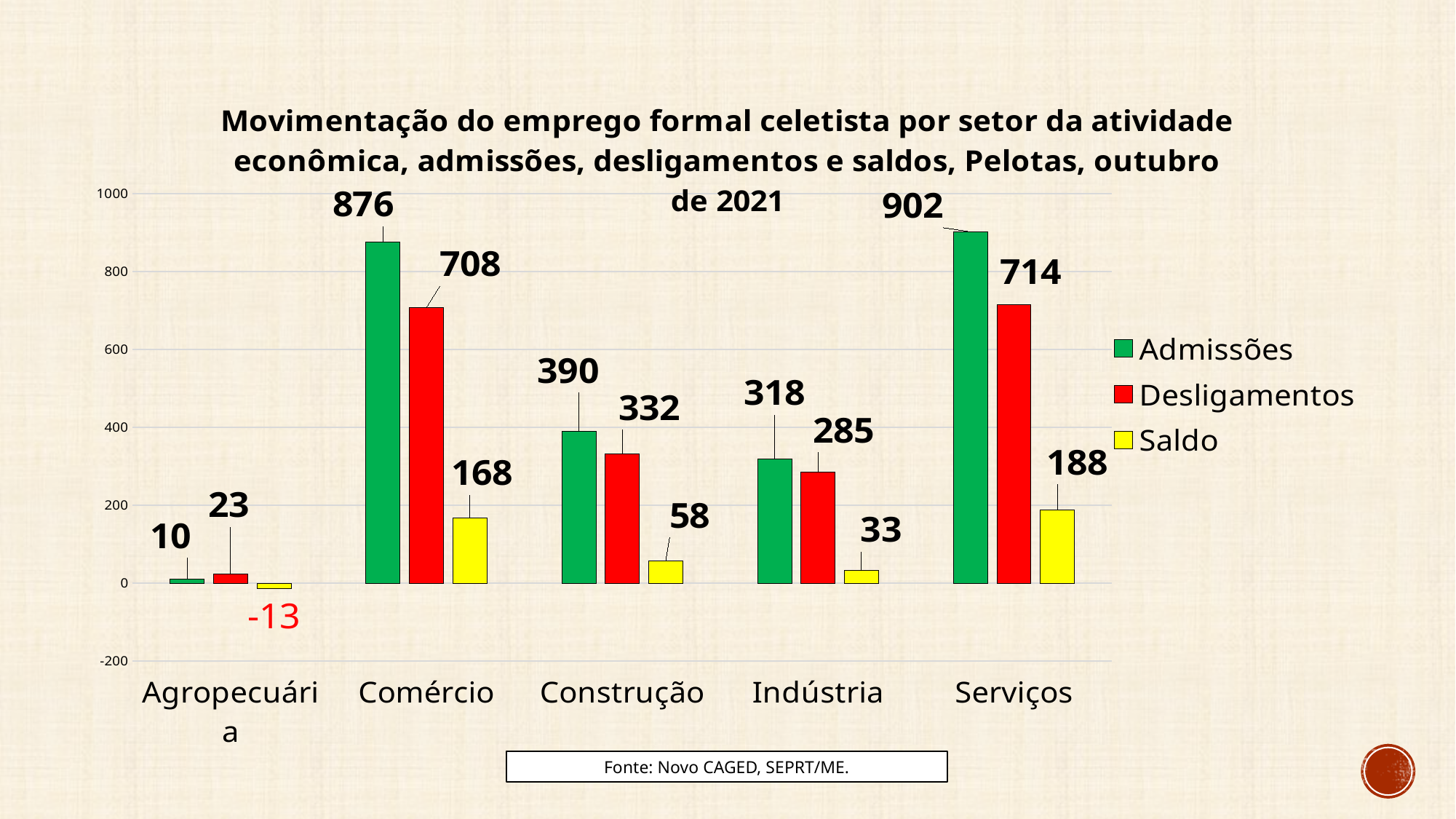
How many sectors are shown on the x axis? 5 What is the Admissões value for Comércio? 876 Which sector has the lowest Saldo value? Agropecuária How many series does the legend list? 3 Which is larger, the Desligamentos value for Construção or for Indústria? Construção What kind of chart is shown on the slide? Bar chart What is the Desligamentos value for Indústria? 285 What is the Saldo value for Agropecuária? -13 Which sector has the highest Admissões value? Serviços What is the difference between the Saldo values for Comércio and Construção? 110 What colour are the Saldo bars? Yellow What is the difference between Admissões and Desligamentos for Serviços? 188